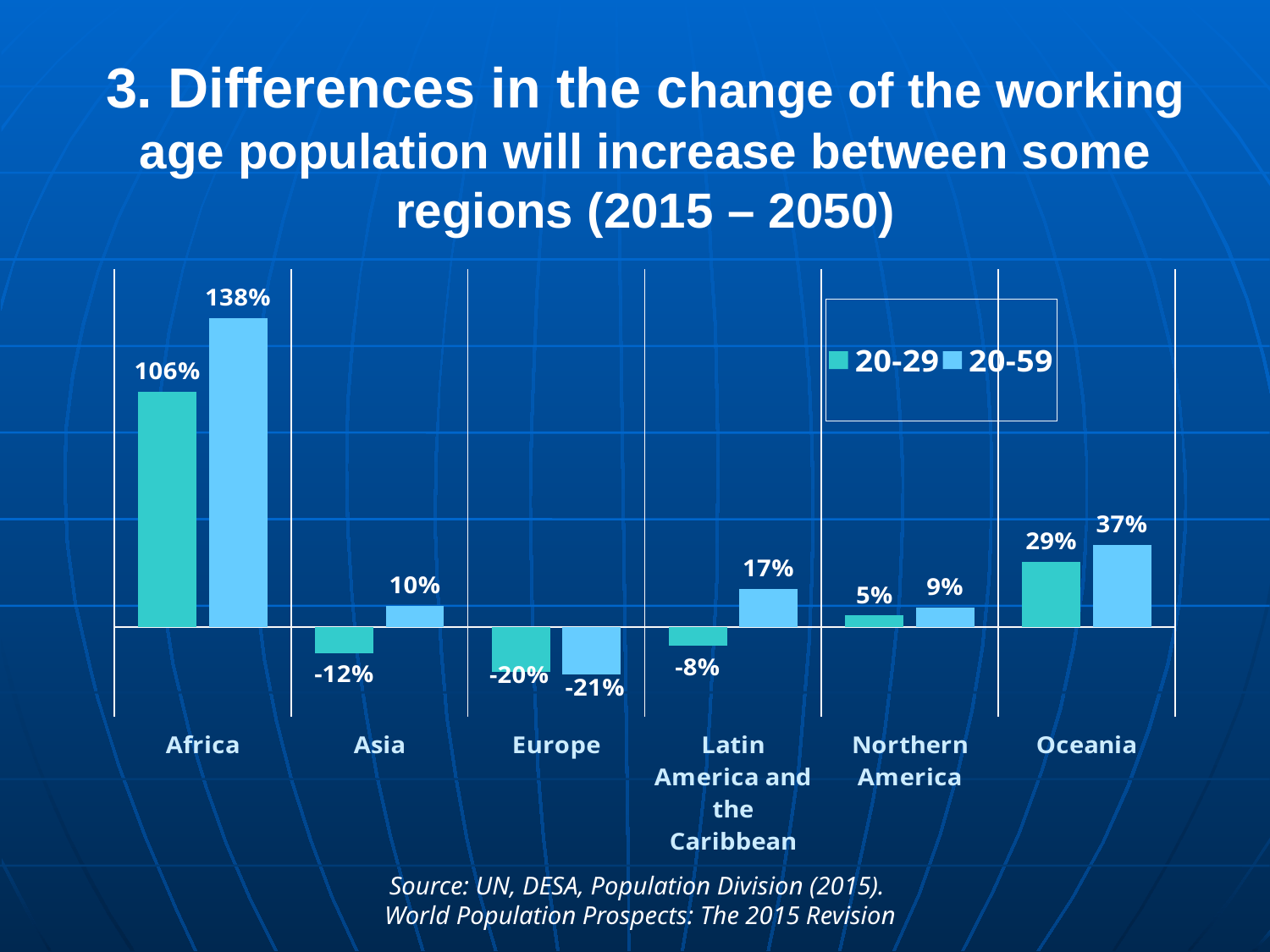
What is the value for Africa in the 20-29 series? 106% Which region has the highest value in the 20-59 series? Africa What is the difference between the 20-59 and 20-29 values for Oceania? 8% What is the value for Latin America and the Caribbean in the 20-29 series? -8% Which is larger, the 20-59 value for Northern America or the 20-59 value for Latin America and the Caribbean? Latin America and the Caribbean Which region has the lowest value in the 20-29 series? Europe How many regions are shown on the x axis? 6 What are the two series named in the legend? 20-29 and 20-59 What kind of chart is shown on the slide? Bar chart What is the difference between the 20-59 values for Africa and Asia? 128% How many series does the legend list? 2 What is the value for Europe in the 20-59 series? -21%